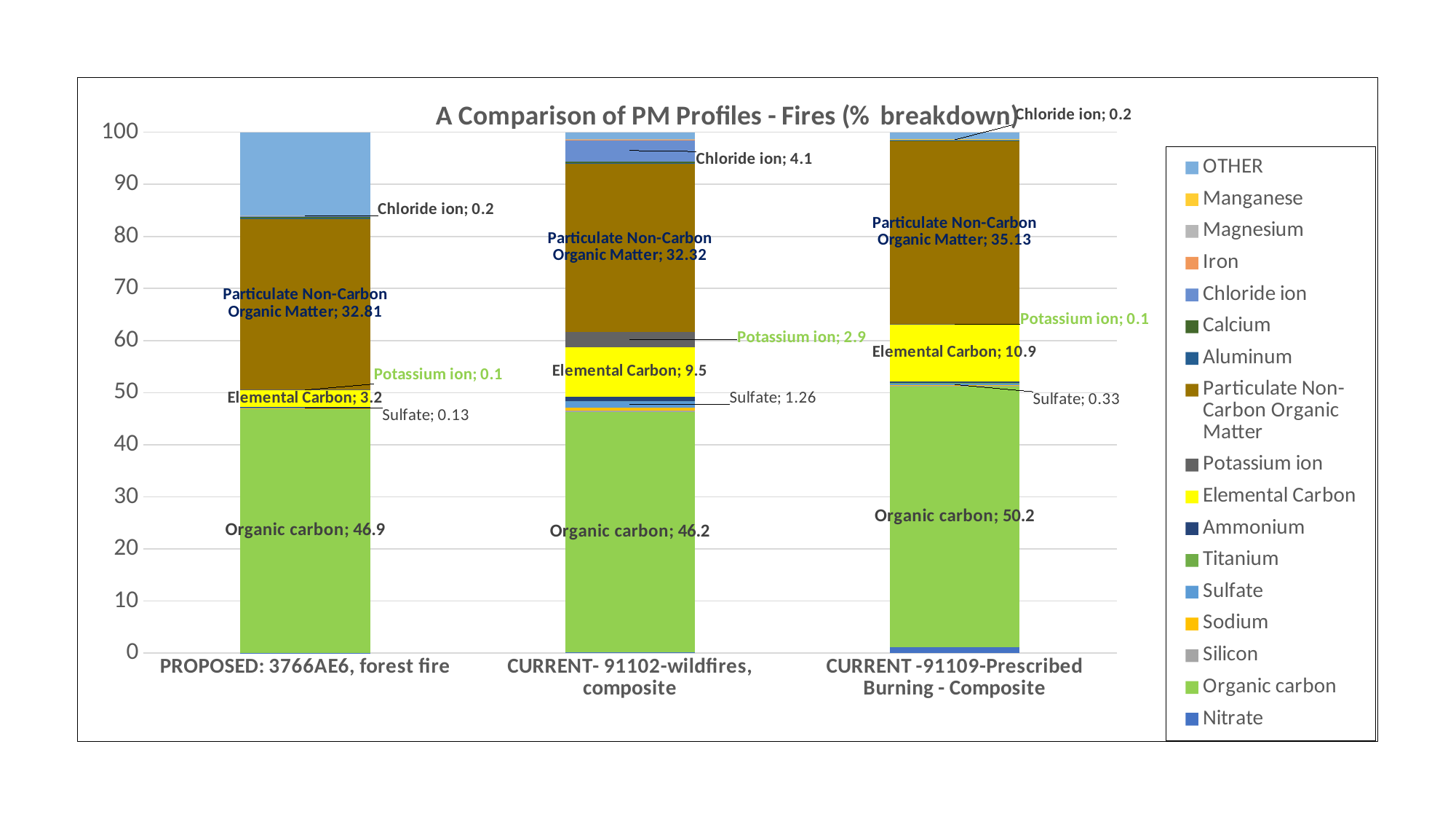
How many series does the legend list? 17 Which profile has the highest Organic carbon value? CURRENT -91109-Prescribed Burning - Composite What is the Organic carbon value for the PROPOSED: 3766AE6, forest fire profile? 46.9 Which profile has the lowest Elemental Carbon value? PROPOSED: 3766AE6, forest fire What is the difference in Particulate Non-Carbon Organic Matter between the CURRENT -91109-Prescribed Burning - Composite profile and the PROPOSED: 3766AE6, forest fire profile? 2.32 Which is larger: the Sulfate value for CURRENT- 91102-wildfires, composite or for CURRENT -91109-Prescribed Burning - Composite? CURRENT- 91102-wildfires, composite What type of chart is shown on the slide? Stacked bar chart What is the Particulate Non-Carbon Organic Matter value for the CURRENT- 91102-wildfires, composite profile? 32.32 How many profiles (bars) are compared in the chart? 3 What is the title of the chart? A Comparison of PM Profiles - Fires (% breakdown) What is the Elemental Carbon value for the CURRENT -91109-Prescribed Burning - Composite profile? 10.9 What is the Chloride ion value for the CURRENT- 91102-wildfires, composite profile? 4.1